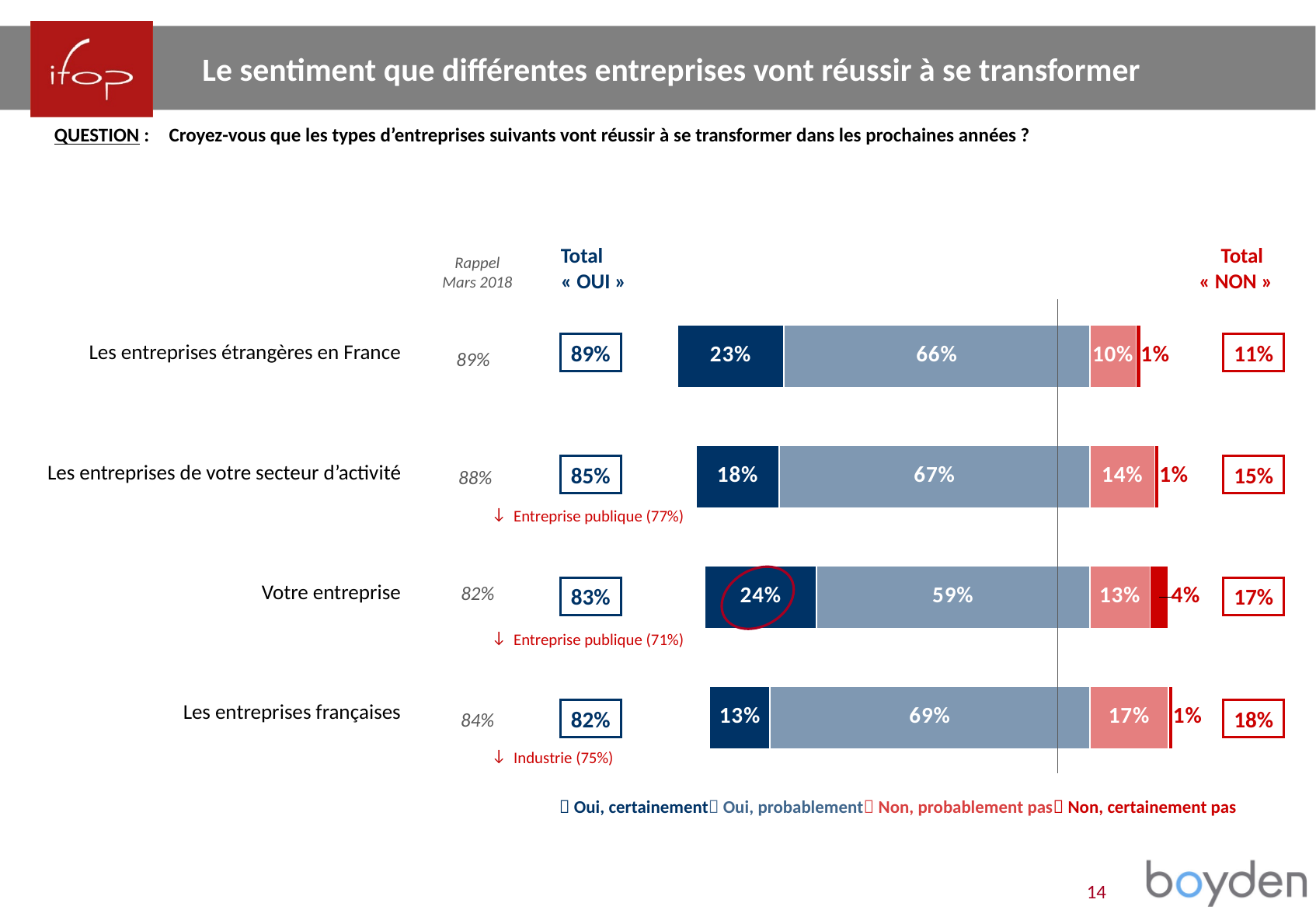
Which category has the highest "Oui, certainement" value? Votre entreprise What is the value of "Oui, probablement" for "Les entreprises françaises"? 69% What is the difference between the "Non, probablement pas" values for "Les entreprises françaises" and "Les entreprises étrangères en France"? 7% Which is larger: the "Oui, certainement" value for "Les entreprises de votre secteur d'activité" or for "Les entreprises françaises"? Les entreprises de votre secteur d'activité What is the value of "Non, certainement pas" for "Votre entreprise"? 4% What is the Total « NON » for "Les entreprises françaises"? 18% Which category has the lowest "Oui, probablement" value? Votre entreprise What is the value of "Oui, certainement" for "Les entreprises étrangères en France"? 23% How many categories (types of companies) are shown in the chart? 4 What is the Total « OUI » for "Les entreprises de votre secteur d'activité"? 85% What kind of chart is shown on the slide? Stacked bar chart How many series does the legend list? 4